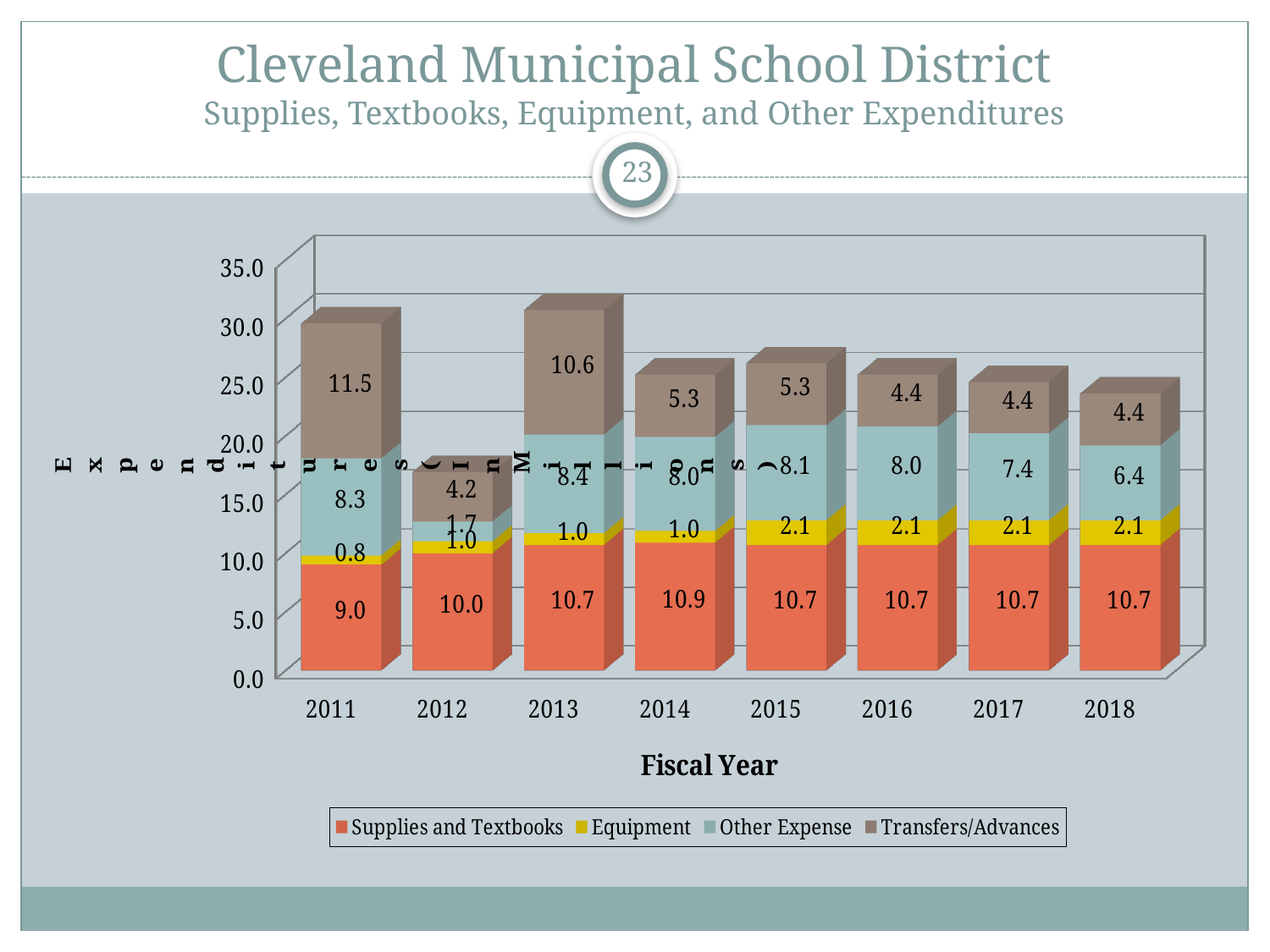
How many fiscal years are shown on the x axis? 8 In which fiscal year is the Transfers/Advances value highest? 2011 What is the Transfers/Advances value for fiscal year 2011? 11.5 What is the title of the x axis? Fiscal Year Does the Other Expense value rise or fall from 2015 to 2018? Fall In which fiscal year is the Supplies and Textbooks value lowest? 2011 What is the difference between the Transfers/Advances value in 2011 and in 2018? 7.1 What kind of chart is shown on the slide? Stacked bar chart How many series does the legend list? 4 What is the Supplies and Textbooks value for fiscal year 2014? 10.9 Which year has the larger Other Expense value, 2017 or 2018? 2017 What is the total of the stacked bar for fiscal year 2018? 23.6